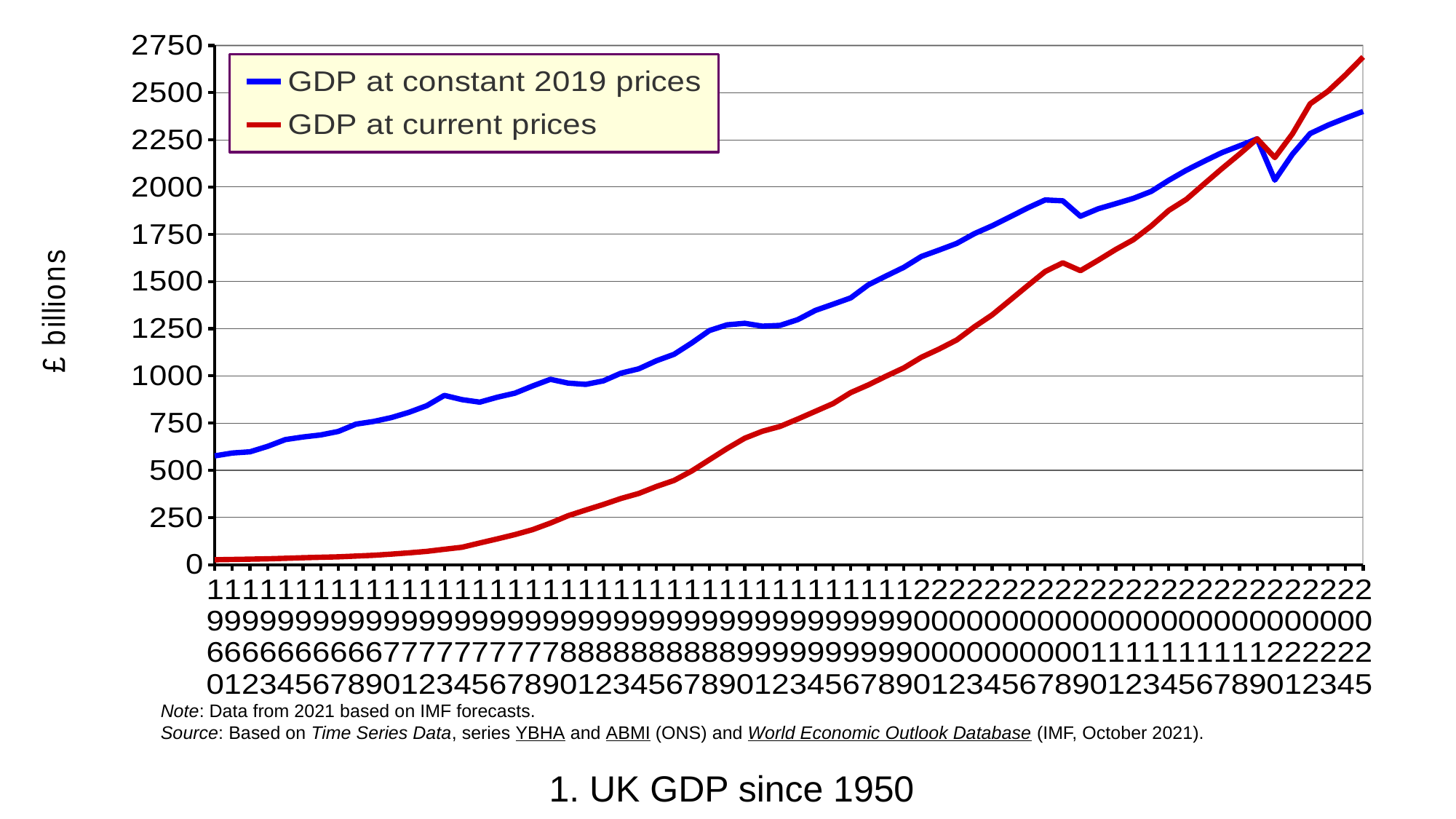
In 1980, which series has the higher value: GDP at constant 2019 prices or GDP at current prices? GDP at constant 2019 prices What kind of chart is shown on the slide? Line chart Is the value for GDP at current prices in 1960 greater or less than 250? less What is the title of the chart? 1. UK GDP since 1950 Is the value for GDP at current prices in 1990 greater or less than 500? greater What is the label on the vertical axis? £ billions How many series does the legend list? 2 Is the value for GDP at constant 2019 prices in 2010 greater or less than 1750? greater In 2025, which series has the higher value: GDP at constant 2019 prices or GDP at current prices? GDP at current prices Overall, do the values for GDP at constant 2019 prices rise or fall across the years shown? Rise Overall, do the values for GDP at current prices rise or fall from 1960 to 2025? Rise